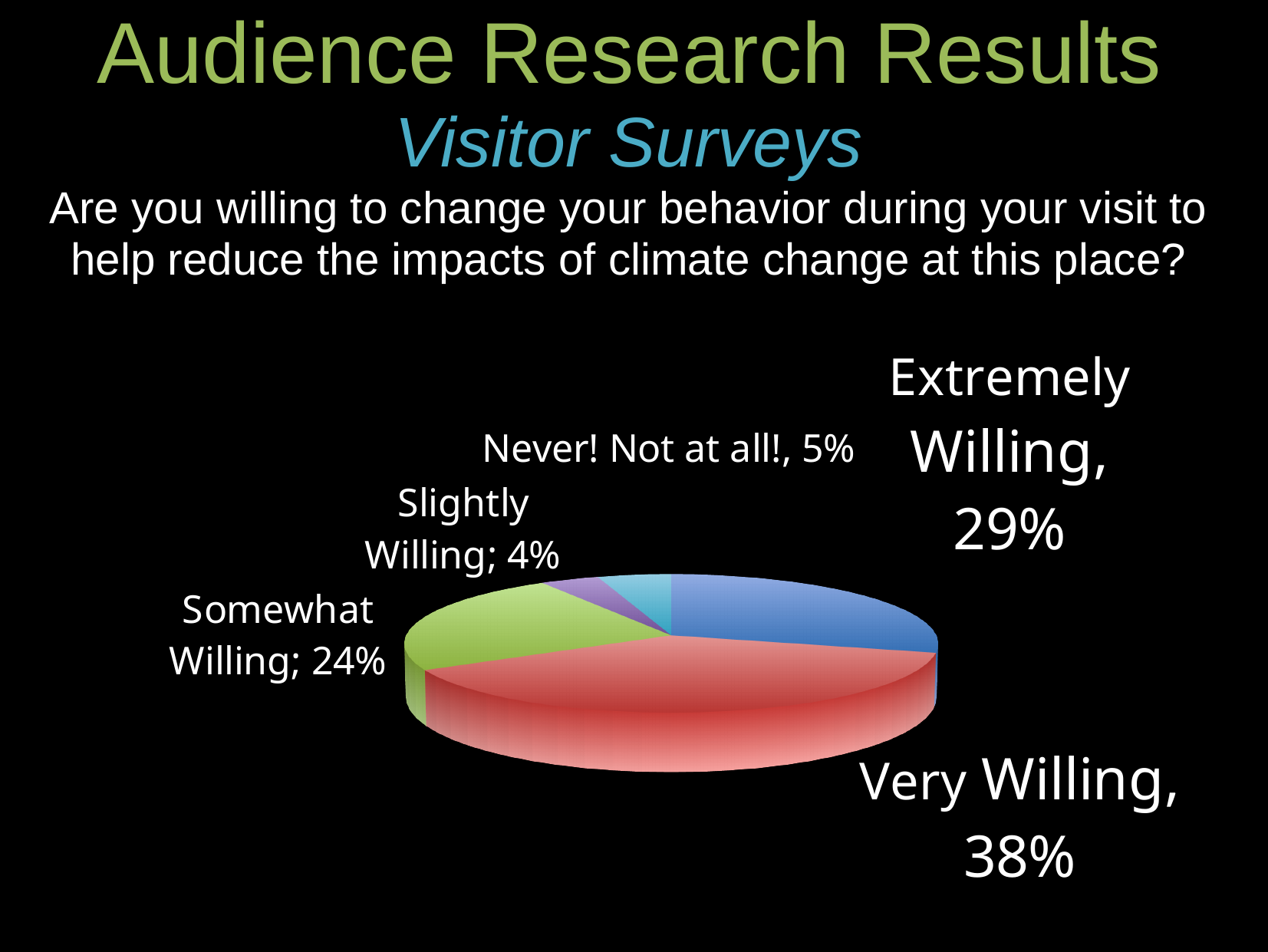
What kind of chart is shown on the slide? Pie chart What percentage of visitors said they were Somewhat Willing? 24% What percentage of visitors said they were Very Willing to change their behavior? 38% What colour is the Very Willing slice of the pie? Red Which response category has the smallest share of the pie? Slightly Willing How many response categories are shown in the pie chart? 5 What percentage of visitors answered Slightly Willing? 4% What is the difference in percentage points between Very Willing and Extremely Willing? 9 What percentage of visitors answered Never! Not at all!? 5% Which is larger, the share for Somewhat Willing or the share for Extremely Willing? Extremely Willing Which response category has the largest share of the pie? Very Willing What percentage of visitors said they were Extremely Willing? 29%